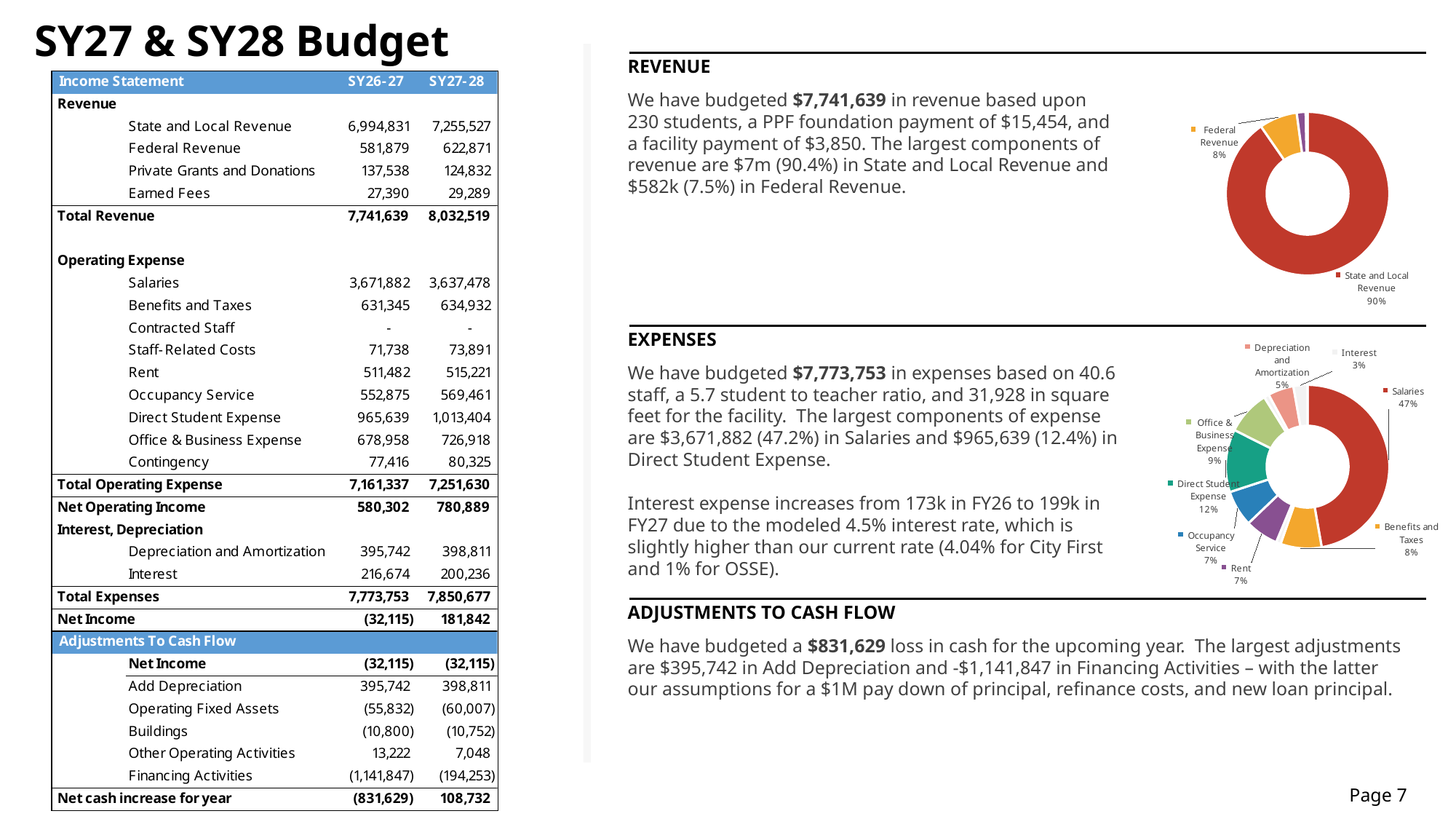
In the revenue chart, what share of revenue is State and Local Revenue? 90% How many labeled categories does the expenses chart show? 8 In the expenses chart, which is larger: Office & Business Expense or Benefits and Taxes? Office & Business Expense What kind of chart is the revenue chart on the right of the slide? Donut (pie) chart In the revenue chart, what share of revenue is Federal Revenue? 8% In the expenses chart, what share of expenses is Direct Student Expense? 12% In the revenue chart, which labeled category has the largest share? State and Local Revenue In the expenses chart, how many percentage points larger is the Salaries share than the Direct Student Expense share? 35 In the expenses chart, which category has the largest share? Salaries